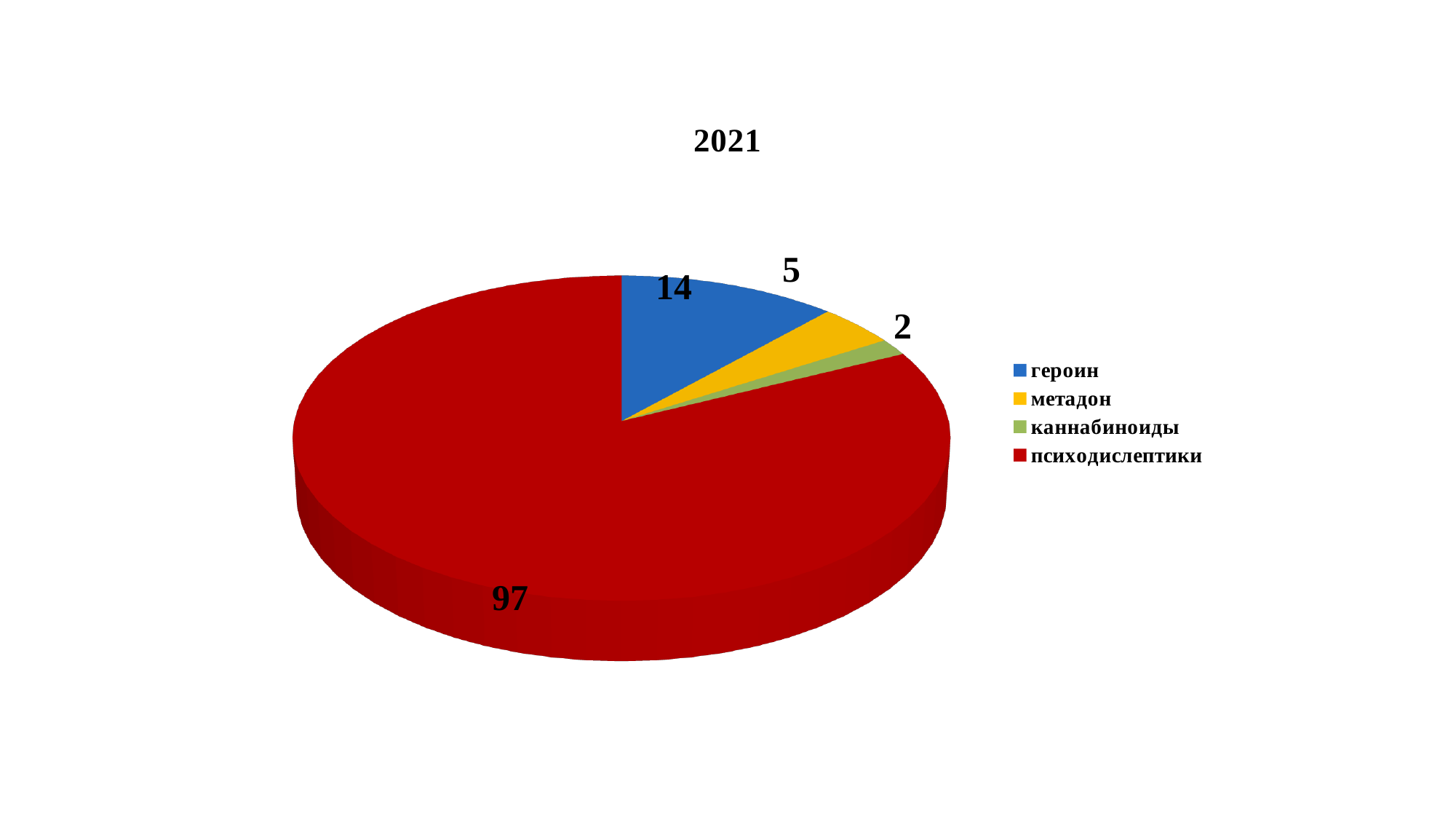
What is the difference between the values for психодислептики and героин? 83 Which category has the smallest slice in the 2021 pie chart? каннабиноиды What is the difference between the values for героин and метадон? 9 What is the value for психодислептики in the 2021 pie chart? 97 What type of chart is shown on the slide? pie chart What is the title of the chart? 2021 What is the value for каннабиноиды in the 2021 pie chart? 2 Which category has the largest slice in the 2021 pie chart? психодислептики What is the value for героин in the 2021 pie chart? 14 What is the value for метадон in the 2021 pie chart? 5 Which is larger, the value for метадон or the value for каннабиноиды? метадон How many categories are shown in the pie chart? 4